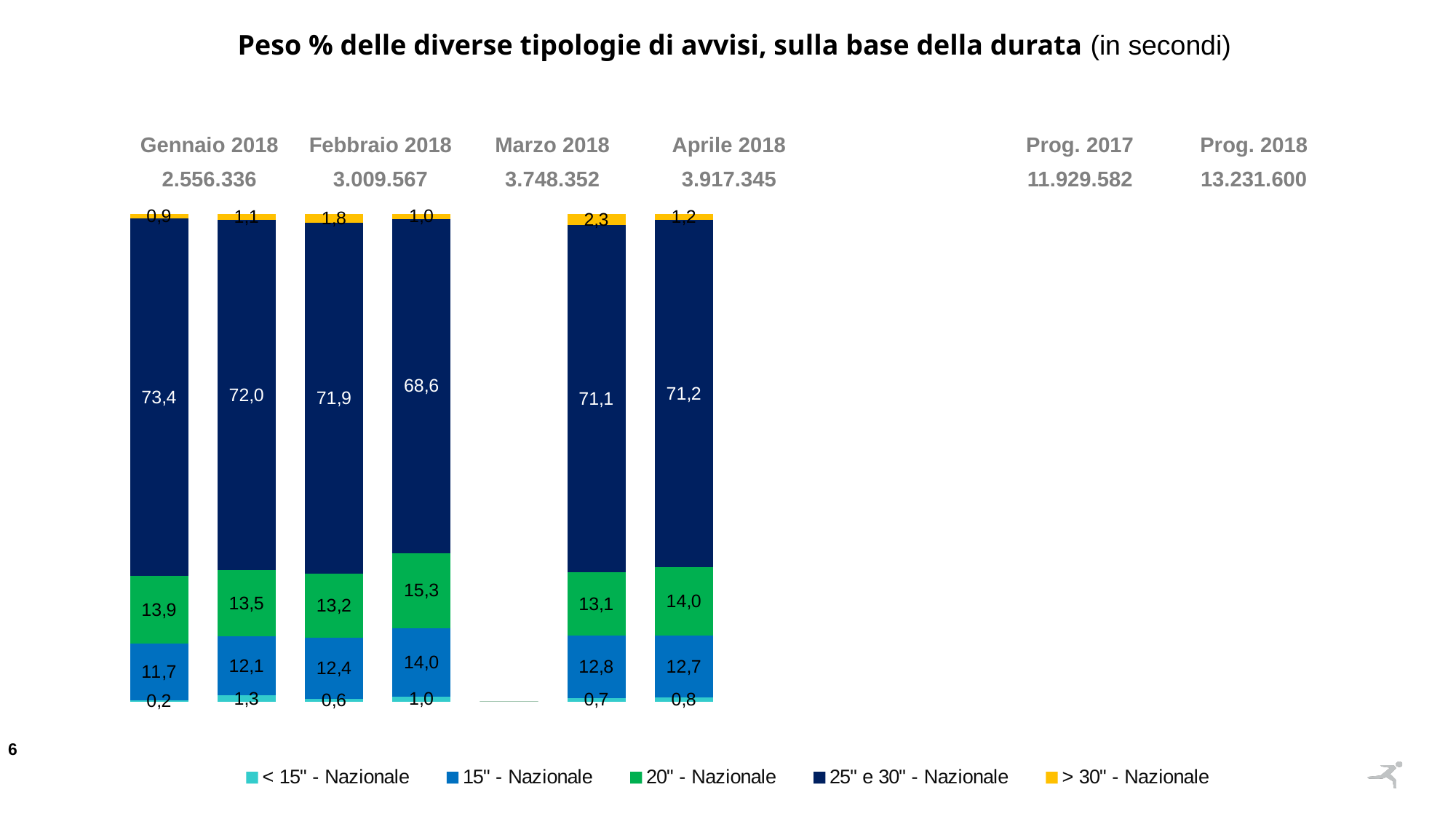
What is the value of the 25'' e 30'' - Nazionale segment for Gennaio 2018? 73,4 Which bar has the lowest value for the 25'' e 30'' - Nazionale series? Aprile 2018 Which bar has the highest value for the 25'' e 30'' - Nazionale series? Gennaio 2018 Which is larger, the 20'' - Nazionale value for Febbraio 2018 or for Marzo 2018? Febbraio 2018 What is the value of the > 30'' - Nazionale segment for Prog. 2017? 2,3 What is the value of the 15'' - Nazionale segment for Prog. 2018? 12,7 How many bars are plotted in the chart? 6 What total number is printed under the Prog. 2018 label? 13.231.600 How many series does the legend list? 5 What is the difference between the 15'' - Nazionale values for Aprile 2018 and Gennaio 2018? 2,3 What is the value of the 20'' - Nazionale segment for Aprile 2018? 15,3 What kind of chart is shown on the slide? Stacked bar chart